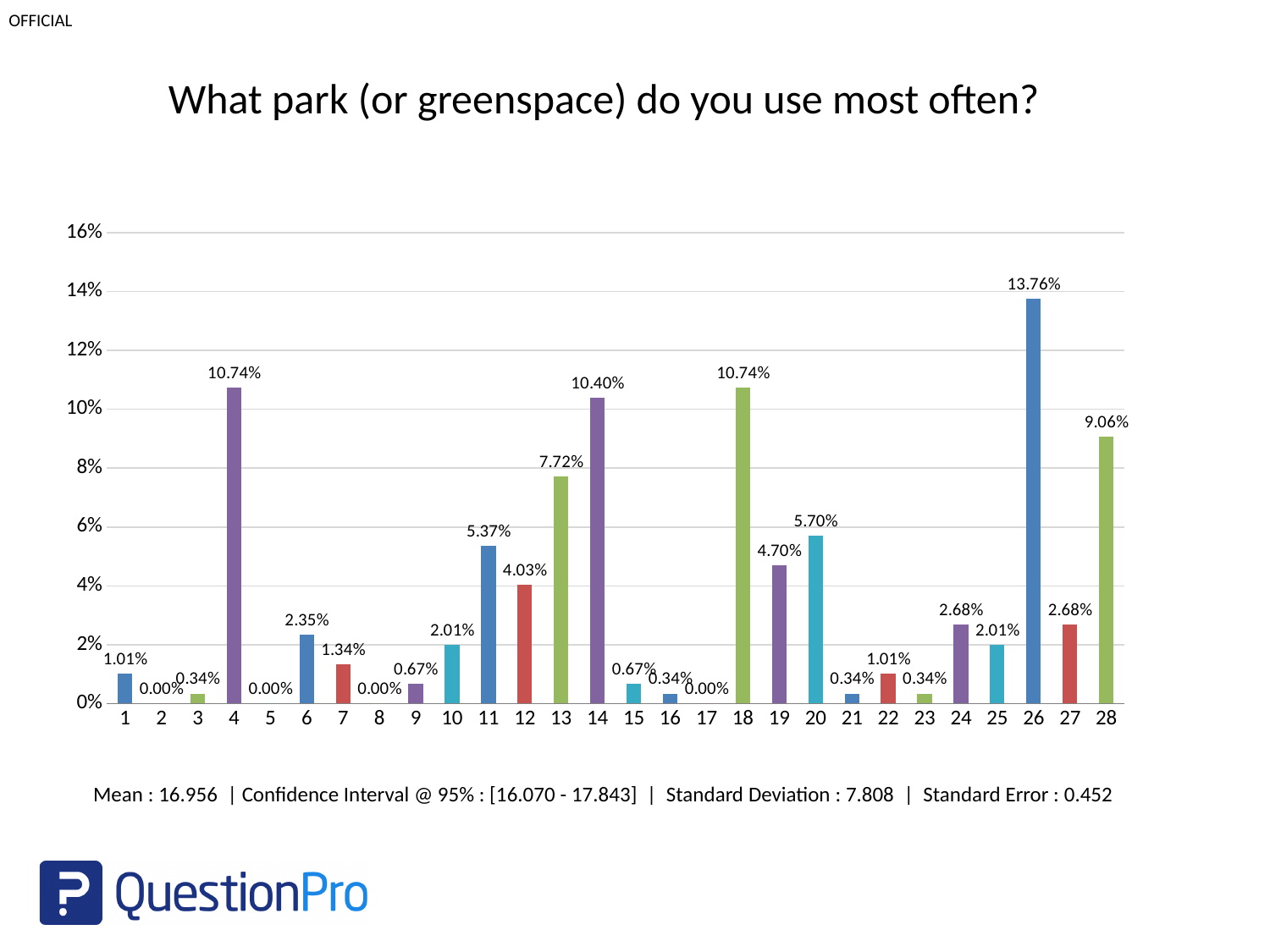
What is the difference between the values for category 26 and category 28? 4.70% What is the value for category 13? 7.72% What is the difference between the values for category 14 and category 13? 2.68% What is the value for category 26? 13.76% Which is larger, the value for category 11 or the value for category 20? category 20 Which category has the highest value? 26 Is the value for category 28 greater or less than 8%? greater What is the title of the chart? What park (or greenspace) do you use most often? How many categories are shown on the x axis? 28 Which is larger, the value for category 6 or the value for category 12? category 12 What kind of chart is shown on the slide? bar chart What is the value for category 19? 4.70%